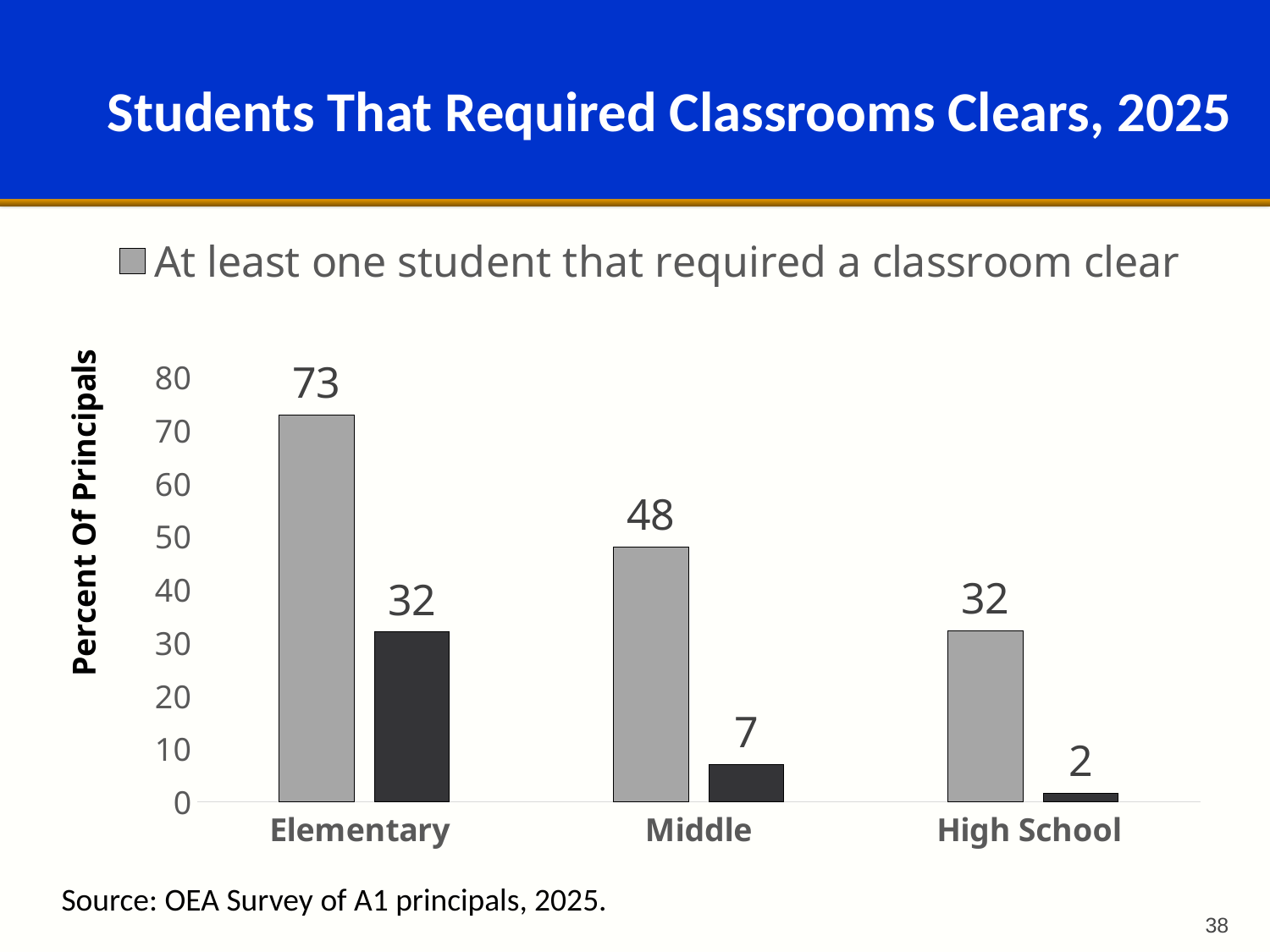
How much higher is the Elementary value than the Middle value for "At least one student that required a classroom clear"? 25 What is the difference between the Middle and High School values for "At least one student that required a classroom clear"? 16 Which school level has the highest value for "At least one student that required a classroom clear"? Elementary What is the value for Elementary in the series "At least one student that required a classroom clear"? 73 For "At least one student that required a classroom clear", is the value larger for Elementary or High School? Elementary Is the Middle value for "At least one student that required a classroom clear" greater or less than 50? less How many school-level categories are shown on the x axis? 3 Which school level has the lowest value for "At least one student that required a classroom clear"? High School What is the value for Middle in the series "At least one student that required a classroom clear"? 48 What is the value for High School in the series "At least one student that required a classroom clear"? 32 Do the values for "At least one student that required a classroom clear" rise or fall from Elementary to High School? fall What kind of chart is shown on the slide? bar chart